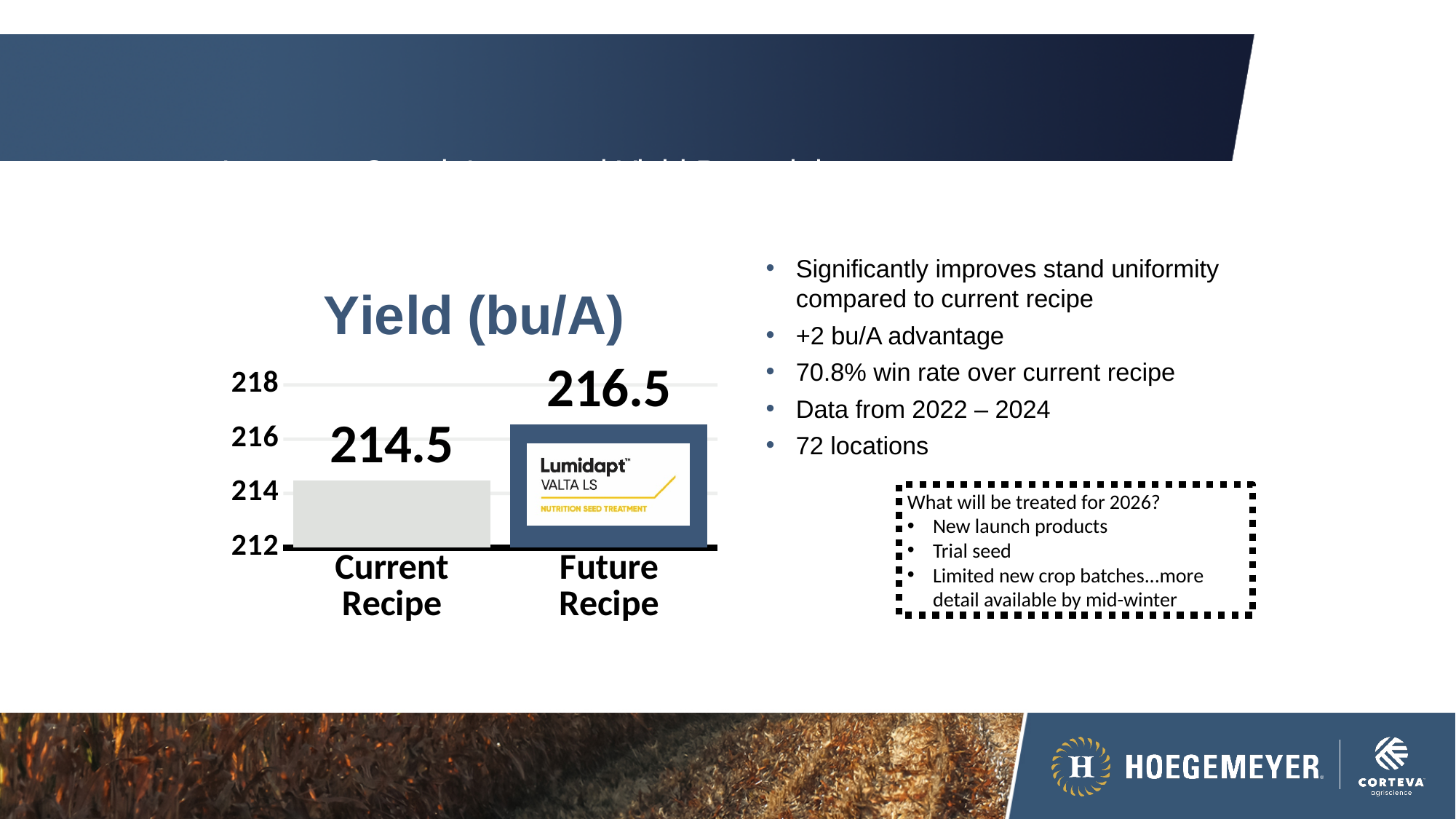
What is the yield value for Future Recipe? 216.5 How many categories are shown in the chart? 2 Which recipe has the lower yield? Current Recipe What is the title of the chart? Yield (bu/A) Is the yield for Current Recipe greater or less than 216? less Which recipe has the higher yield? Future Recipe Is the yield for Future Recipe greater or less than 216? greater What is the difference in yield between Future Recipe and Current Recipe? 2 What kind of chart is shown on the slide? bar chart What is the yield value for Current Recipe? 214.5 What is the lowest value shown on the chart's vertical axis? 212